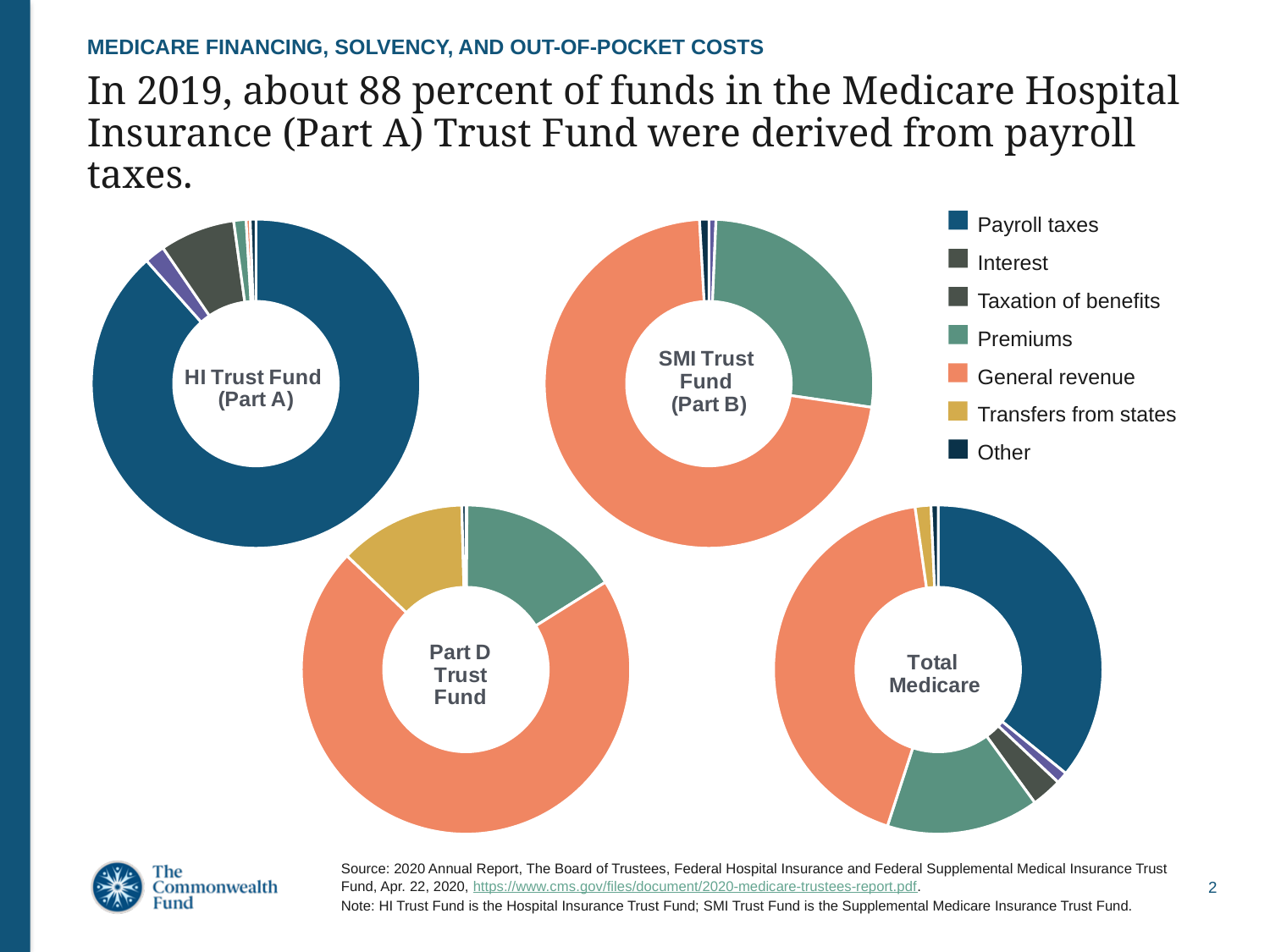
In the SMI Trust Fund (Part B) chart, which funding source has the largest slice? General revenue Which funding source is listed first in the legend? Payroll taxes In the Part D Trust Fund chart, which funding source has the largest slice? General revenue Which colour represents General revenue in the legend? Orange In the HI Trust Fund (Part A) chart, which is larger: Payroll taxes or Interest? Payroll taxes How many entries does the legend list? 7 In the HI Trust Fund (Part A) chart, which funding source has the largest slice? Payroll taxes What kind of chart is used to show the HI Trust Fund (Part A) funding sources? doughnut chart How many pie charts are shown on the slide? 4 In the Part D Trust Fund chart, which is larger: Premiums or Transfers from states? Premiums In the SMI Trust Fund (Part B) chart, which is larger: General revenue or Premiums? General revenue